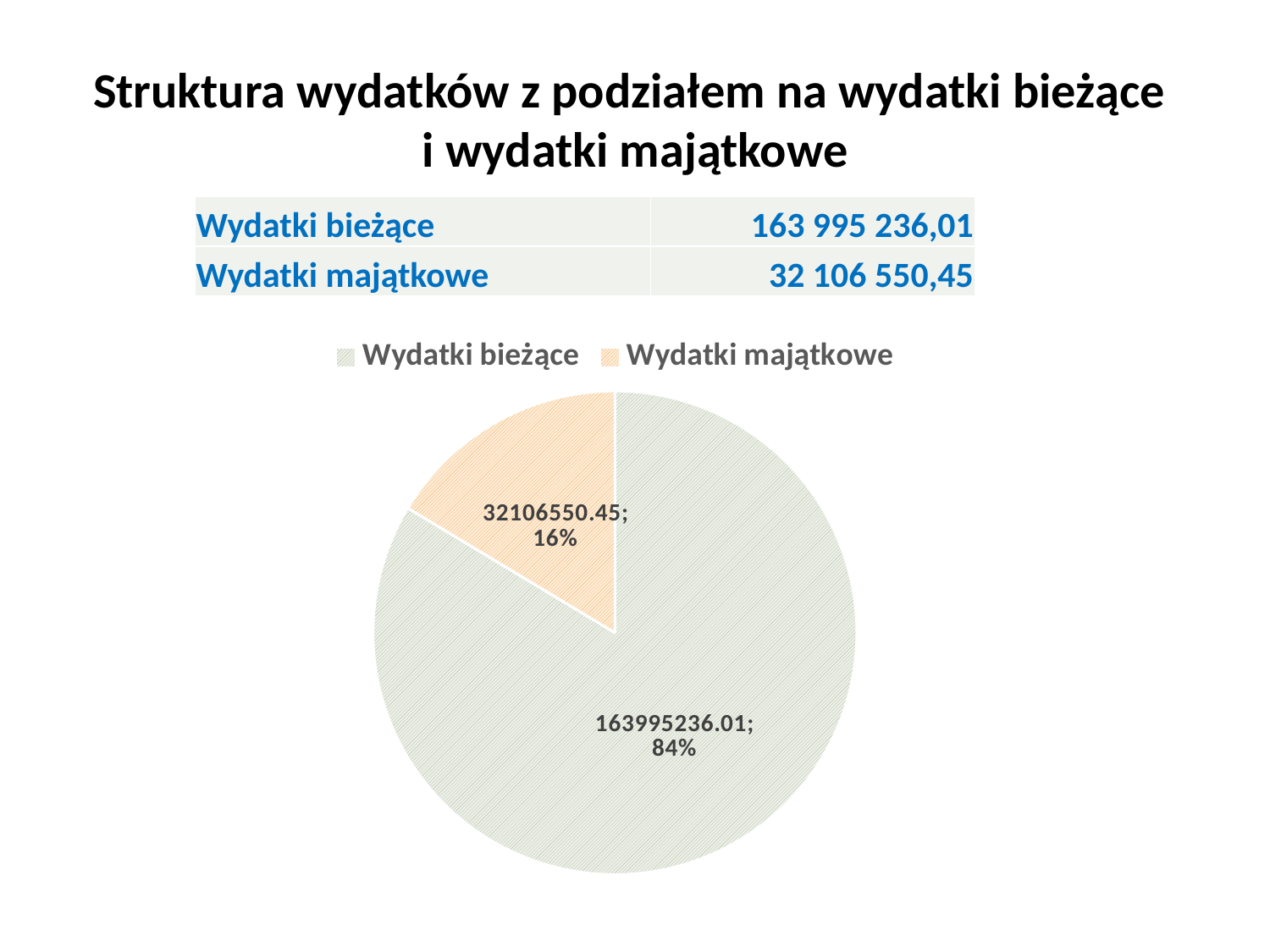
Which slice of the pie chart is the largest? Wydatki bieżące What is the total of the two values labelled on the pie chart? 196101786.46 What value is labelled on the Wydatki bieżące slice of the pie chart? 163995236.01 Which is larger, Wydatki bieżące or Wydatki majątkowe? Wydatki bieżące Which slice of the pie chart is the smallest? Wydatki majątkowe How many entries does the legend of the pie chart list? 2 What is the difference between the Wydatki bieżące value and the Wydatki majątkowe value shown on the pie chart? 131888685.56 What kind of chart is shown on the slide? pie chart What share of the pie does Wydatki bieżące represent? 84% What share of the pie does Wydatki majątkowe represent? 16% How many slices does the pie chart have? 2 What value is labelled on the Wydatki majątkowe slice of the pie chart? 32106550.45